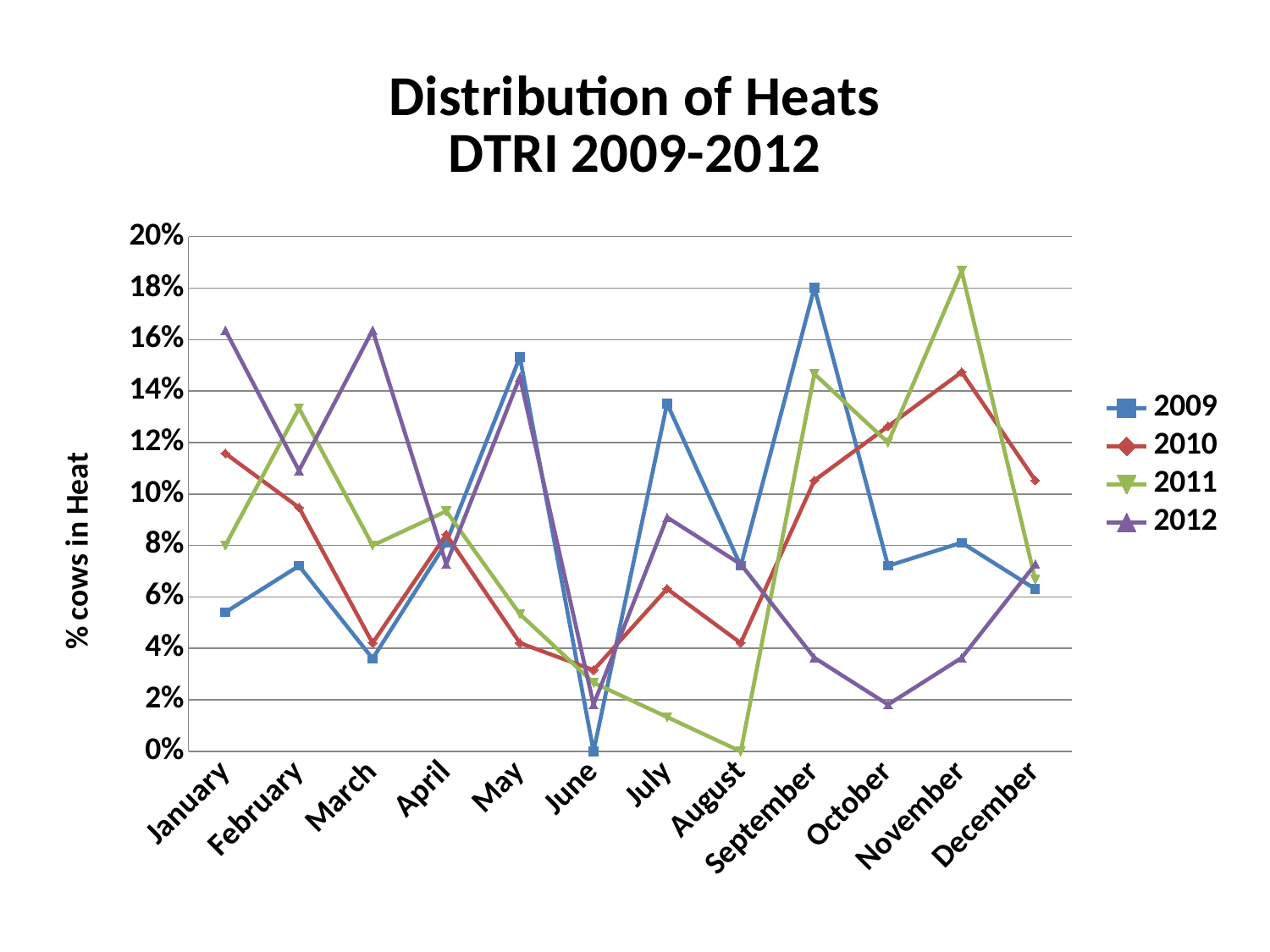
In which month is the 2011 series highest? November In which month is the 2009 series highest? September What is the title of the vertical axis? % cows in Heat Is the value for 2009 in January greater or less than 6%? less In September, which series has the larger value, 2009 or 2012? 2009 What kind of chart is shown on the slide? line chart How many months are shown along the x axis? 12 How many series does the legend list? 4 What is the value for 2011 in August? 0% What is the value for 2009 in June? 0% Is the value for 2011 in November greater or less than 18%? greater